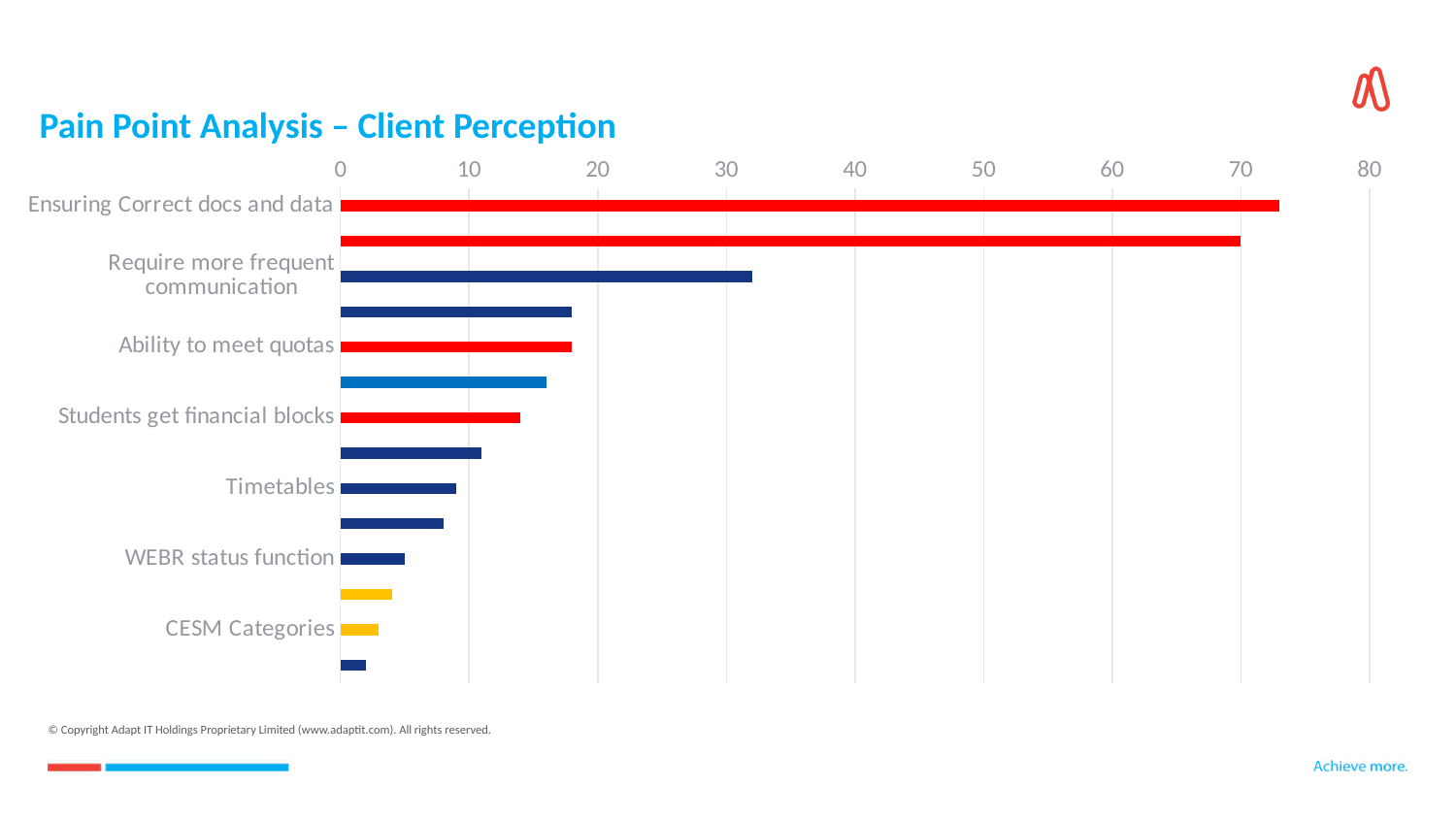
Is the value for WEBR status function greater or less than 10? less What is the title of the chart? Pain Point Analysis – Client Perception Which labelled category has the shortest bar? CESM Categories Is the value for Ensuring Correct docs and data greater or less than 70? greater Is the value for Timetables greater or less than 10? less Which labelled category has the longest bar? Ensuring Correct docs and data What kind of chart is shown on the slide? bar chart How many category labels are shown on the vertical axis? 7 Which is larger, the value for Require more frequent communication or the value for Ability to meet quotas? Require more frequent communication